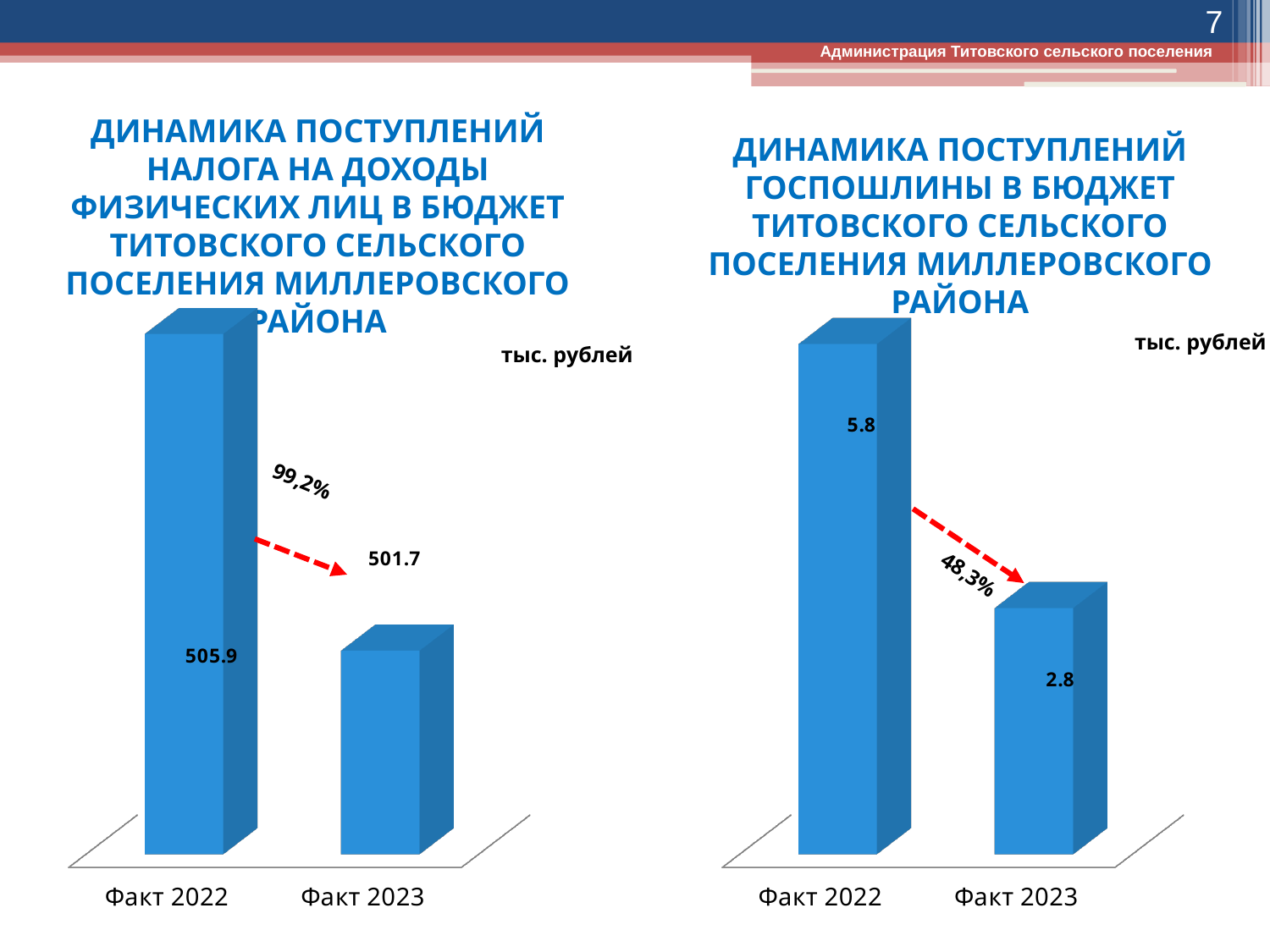
In the left chart (НДФЛ dynamics), what is the difference between the Факт 2022 and Факт 2023 values? 4.2 In the left chart (НДФЛ dynamics), what is the value for Факт 2023? 501.7 How many categories are shown on the x axis of the left chart (НДФЛ dynamics)? 2 In the right chart (госпошлина dynamics), what percentage is written next to the red dashed arrow? 48,3% In the left chart (НДФЛ dynamics), what is the value for Факт 2022? 505.9 In the right chart (госпошлина dynamics), is the value for Факт 2022 larger or smaller than the value for Факт 2023? larger In the right chart (госпошлина dynamics), what is the difference between the Факт 2022 and Факт 2023 values? 3.0 What kind of chart is the right chart (госпошлина dynamics)? bar chart In the right chart (госпошлина dynamics), what is the value for Факт 2023? 2.8 In the left chart (НДФЛ dynamics), which category has the higher value? Факт 2022 In the right chart (госпошлина dynamics), what is the value for Факт 2022? 5.8 In the right chart (госпошлина dynamics), which category has the lowest value? Факт 2023